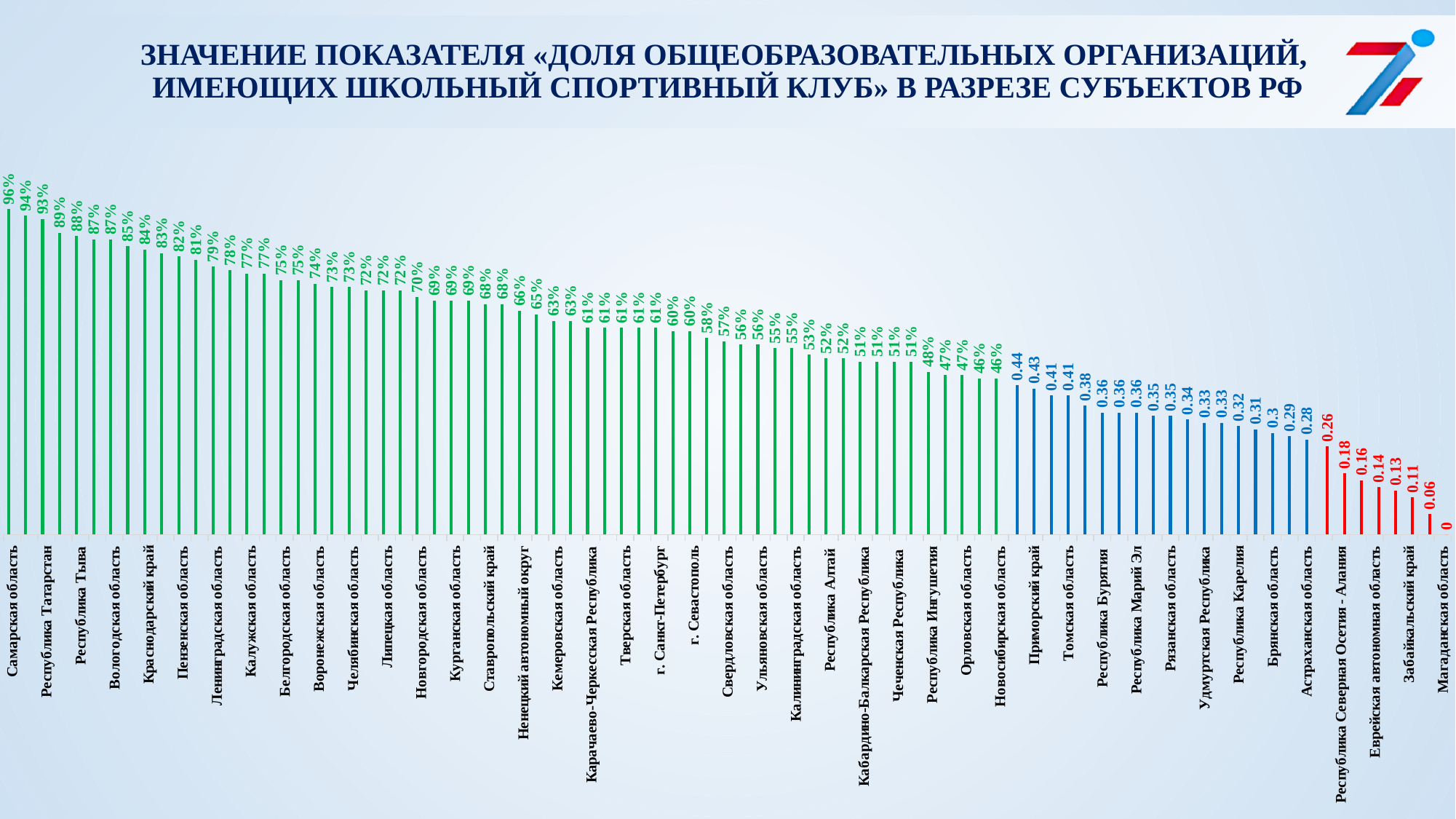
What is the value for Новосибирская область? 46% Which region has the highest value in the chart? Самарская область How many different bar colours are used in the chart? 3 Which region has the lowest value in the chart? Магаданская область Which is larger, the value for Самарская область or for Республика Татарстан? Самарская область Do the values rise or fall from left to right along the x axis? fall What is the value for Магаданская область? 0 What is the difference between the values for Самарская область (96%) and Республика Татарстан (93%)? 3% What is the value for Астраханская область? 0.28 What is the value for Республика Татарстан? 93% What kind of chart is shown on the slide? bar chart What is the value for Самарская область? 96%